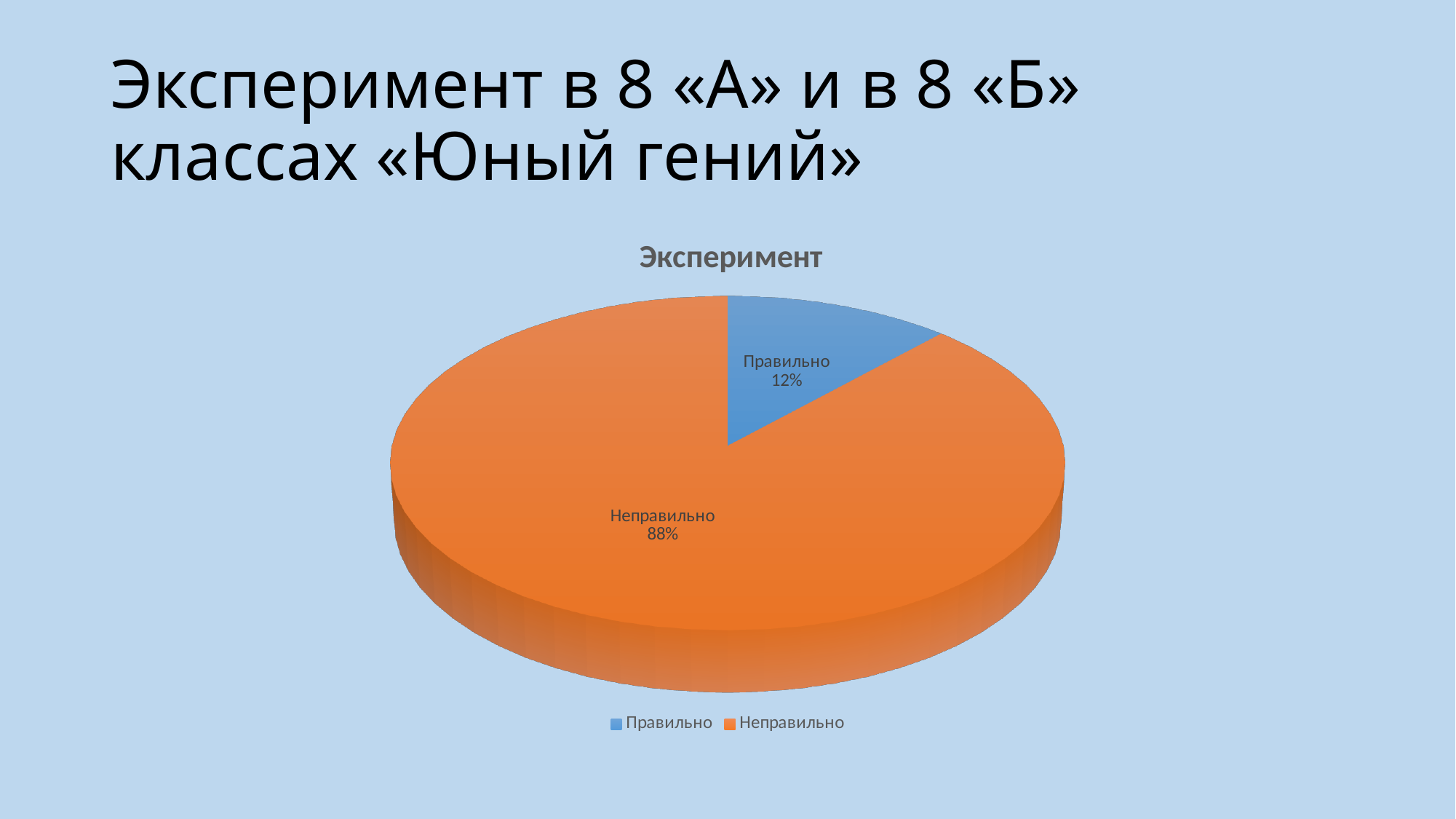
What colour is the "Правильно" slice? Blue How many entries does the legend list? 2 Which is larger, the "Правильно" slice or the "Неправильно" slice? Неправильно How many slices does the pie chart have? 2 Which slice is the smallest in the pie chart? Правильно What share of the pie does the "Правильно" slice represent? 12% What kind of chart is shown on the slide? Pie chart What share of the pie does the "Неправильно" slice represent? 88% What is the title of the chart? Эксперимент Which slice is the largest in the pie chart? Неправильно What is the difference in percentage points between the "Неправильно" and "Правильно" slices? 76